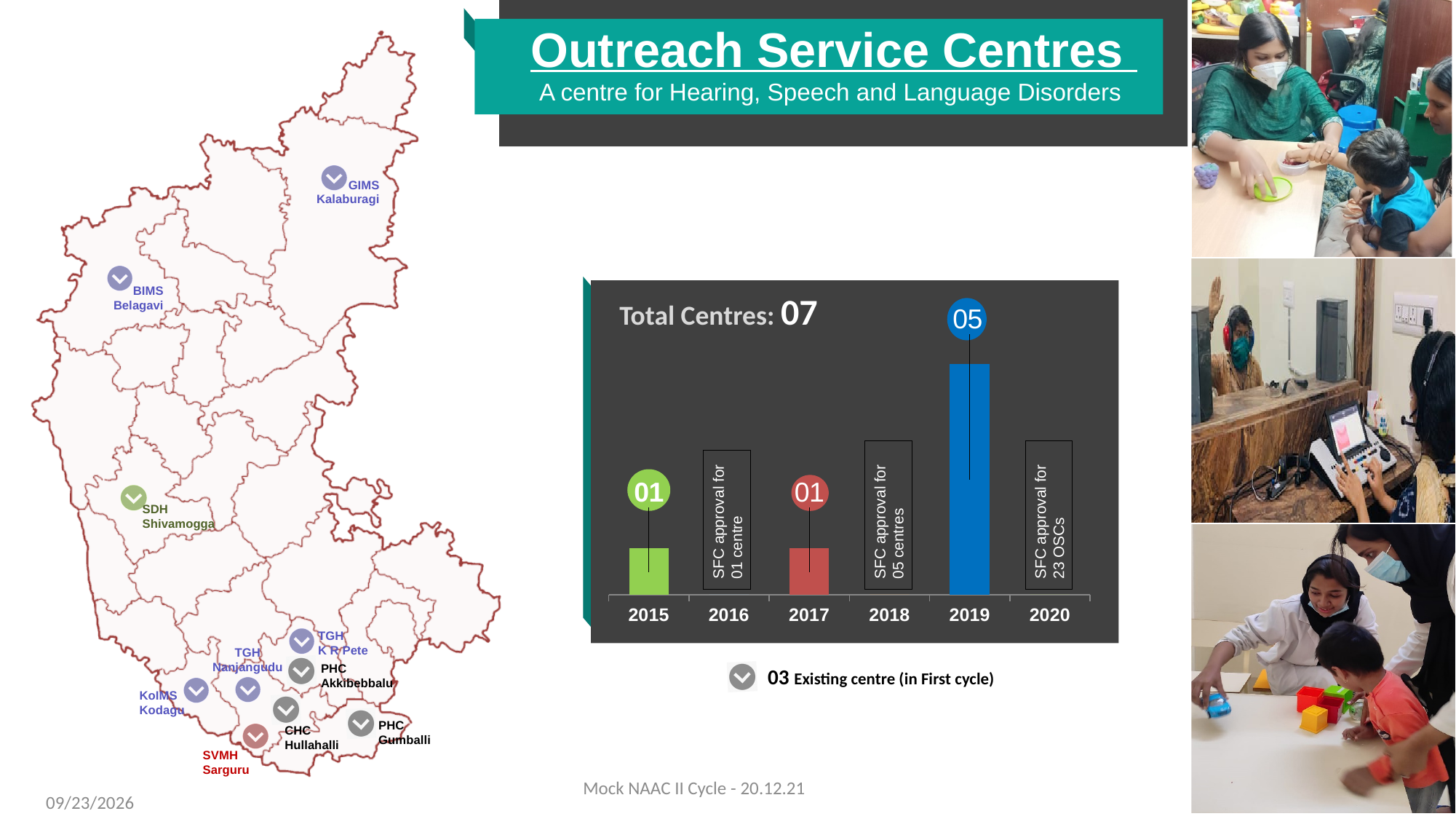
What value is labelled on the bar for 2017? 01 What value is labelled on the bar for 2019? 05 What text is shown in the box at the 2020 position on the chart? SFC approval for 23 OSCs What colour is the bar for 2019? blue What total number of centres is stated in the chart's heading? 07 What value is labelled on the bar for 2015? 01 How many years are labelled along the x axis of the chart? 6 Which year has the tallest bar in the chart? 2019 How many bars are plotted in the chart? 3 What is the difference between the value for 2019 and the value for 2017? 4 What kind of chart is shown on the slide? bar chart Which is larger, the value for 2019 or the value for 2015? 2019